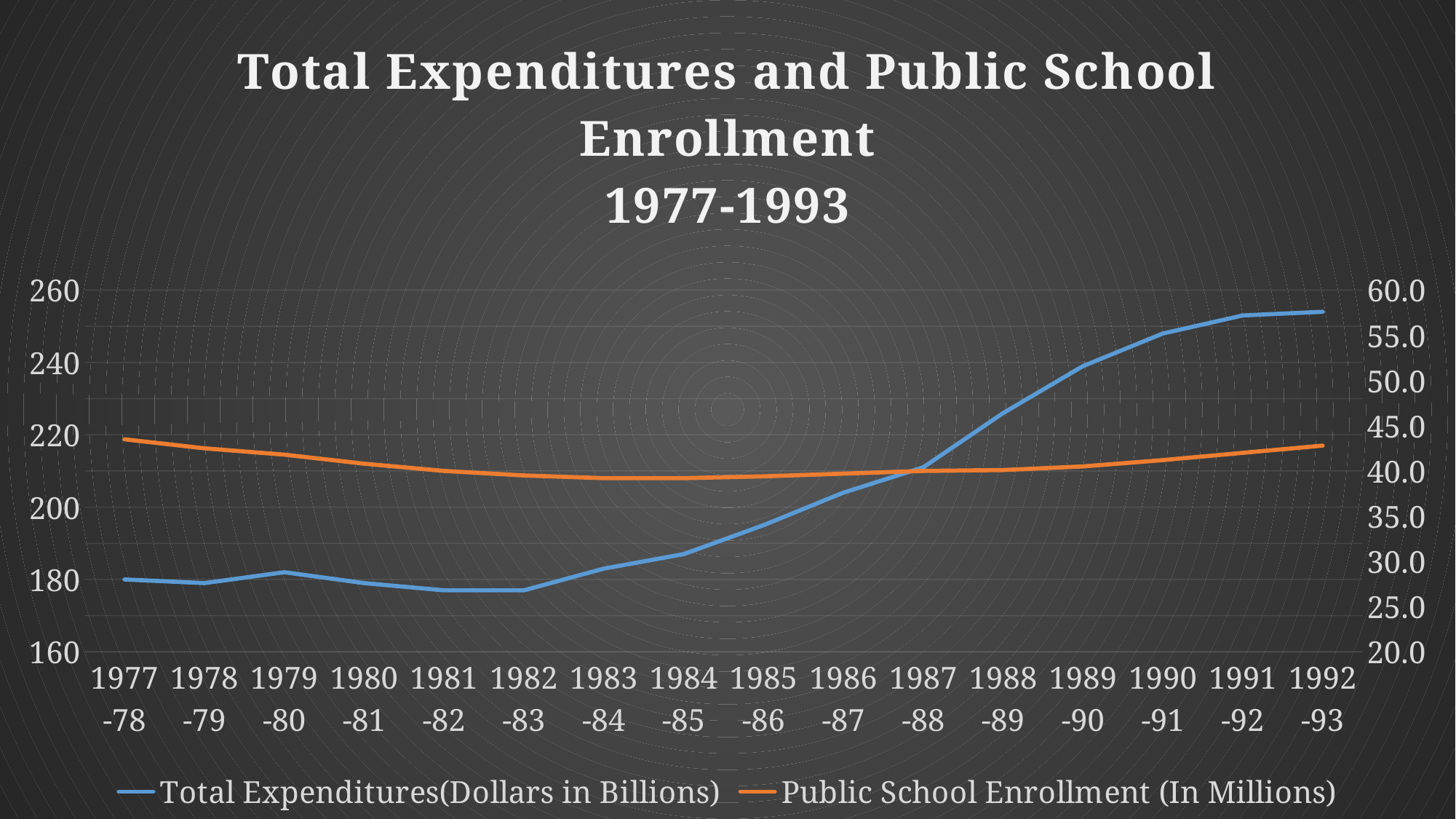
How many series does the legend list? 2 Is the value for Total Expenditures (Dollars in Billions) in 1989-90 greater or less than 220? greater In which school year is Total Expenditures (Dollars in Billions) highest? 1992-93 What kind of chart is shown on the slide? line chart Is the value for Public School Enrollment (In Millions) in 1984-85 greater or less than 45.0? less How many school years are shown along the x axis? 16 Does Total Expenditures (Dollars in Billions) rise or fall from 1982-83 to 1992-93? rise Is the value for Total Expenditures (Dollars in Billions) in 1992-93 greater or less than 240? greater Does Public School Enrollment (In Millions) rise or fall from 1977-78 to 1984-85? fall Which colour is used for the Public School Enrollment (In Millions) line? orange